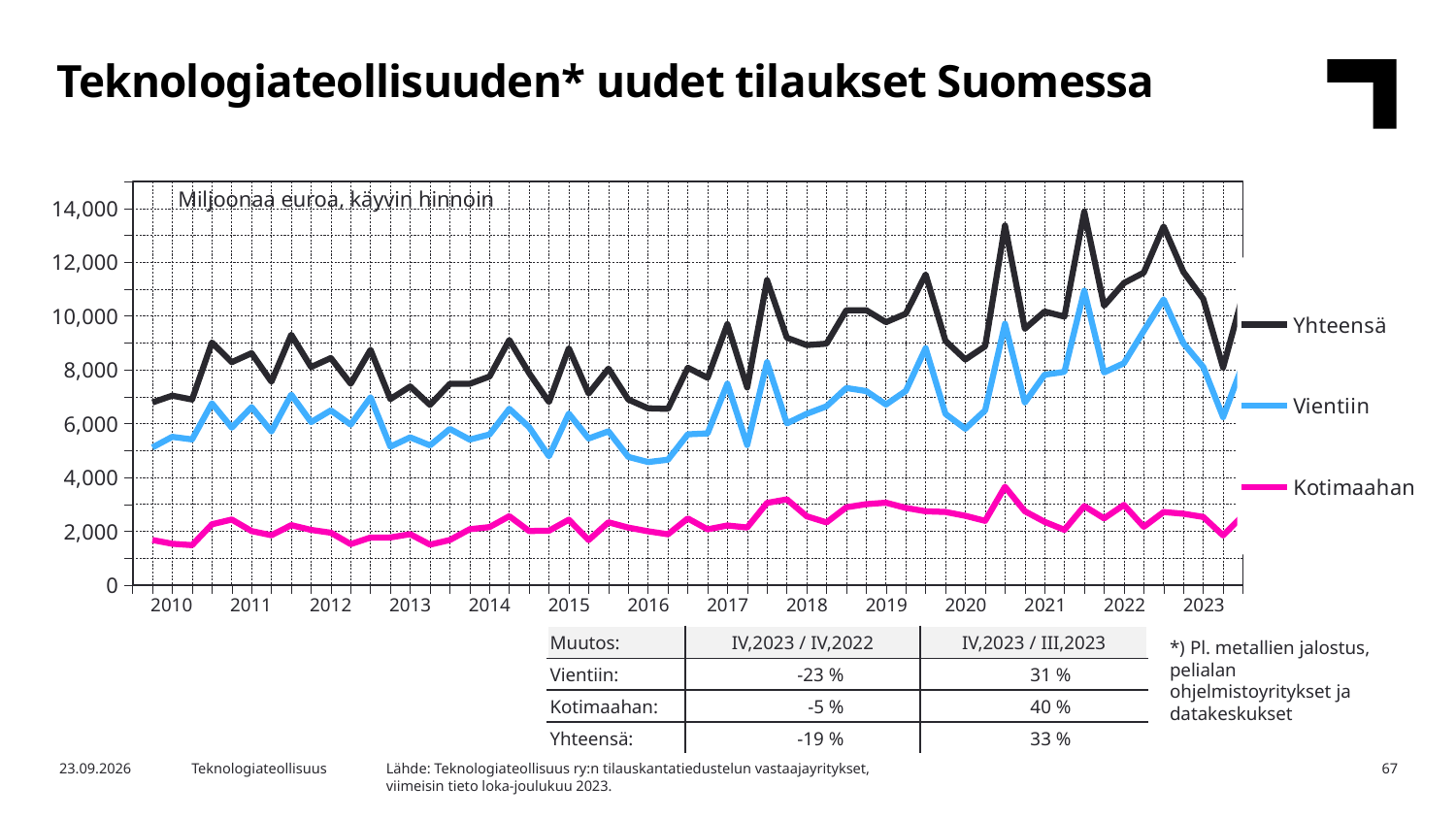
Is the lowest value for Vientiin around 2016 greater or less than 6,000? less How many year labels are shown on the x axis? 14 Is the value for Kotimaahan ever greater or less than 4,000 over the whole period? less Which series has the highest values throughout the chart? Yhteensä What kind of chart is shown on the slide? line chart Is the value for Yhteensä at the start of 2010 greater or less than 8,000? less What unit is stated at the top of the chart area? Miljoonaa euroa, käyvin hinnoin How many series does the legend list? 3 Which series has the lowest values throughout the chart? Kotimaahan Overall, do the Yhteensä values rise or fall from 2010 to 2023? rise Which is larger in 2021, Vientiin or Kotimaahan? Vientiin What are the three series named in the legend? Yhteensä, Vientiin, Kotimaahan